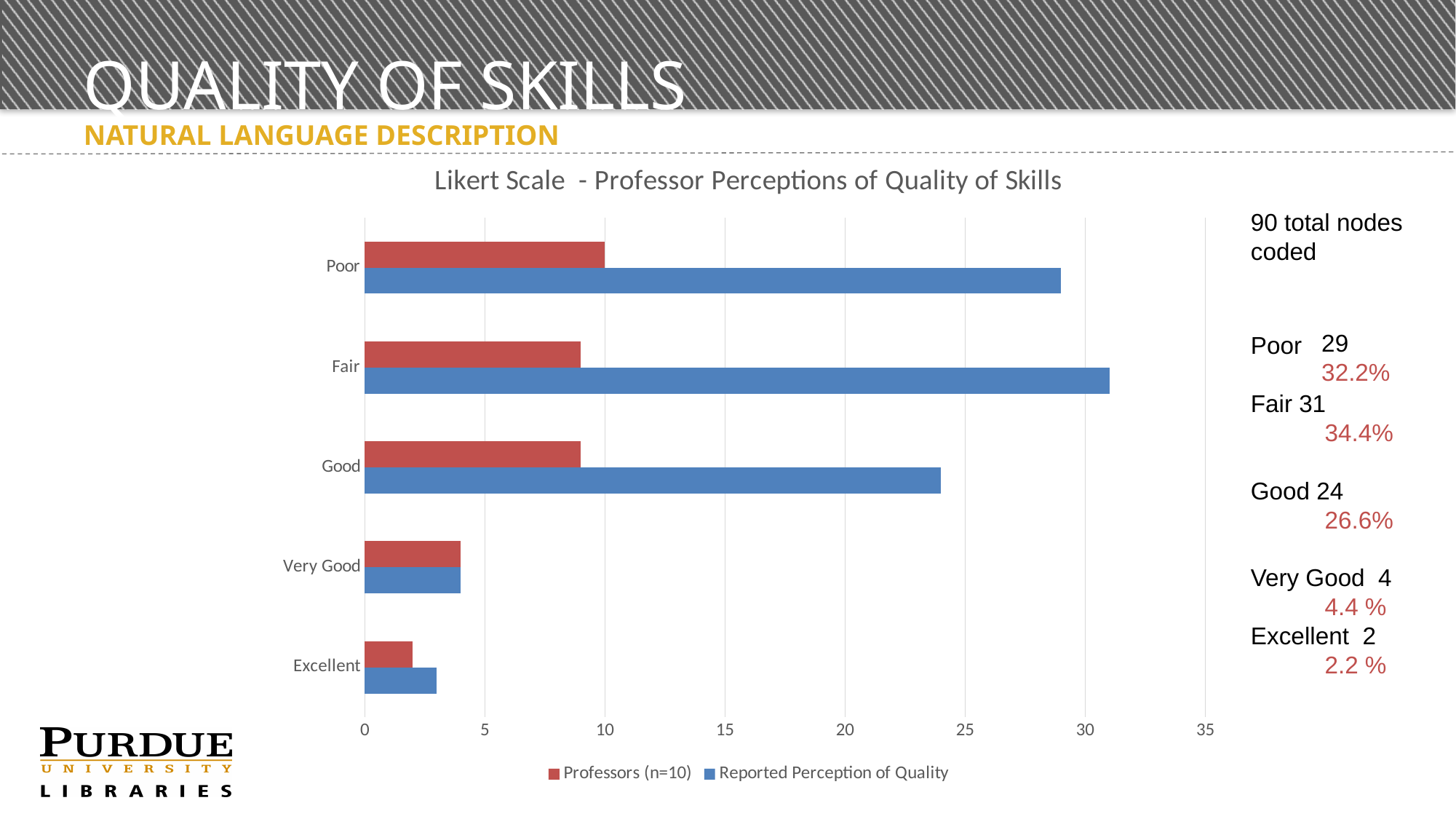
Is the Professors (n=10) value for Fair greater or less than 10? less What is the Reported Perception of Quality value for Fair? 31 What kind of chart is shown on the slide? bar chart Which category has the highest Reported Perception of Quality value? Fair In the Poor category, which series has the larger value, Professors (n=10) or Reported Perception of Quality? Reported Perception of Quality How many categories are shown on the vertical axis of the chart? 5 Which category has the lowest Reported Perception of Quality value? Excellent What is the difference between the Reported Perception of Quality values for Fair and Poor? 2 Is the Reported Perception of Quality value for Good greater or less than 20? greater Which colour represents the Professors (n=10) series in the chart? red How many series does the legend list? 2 What is the value for Professors (n=10) in the Poor category? 10